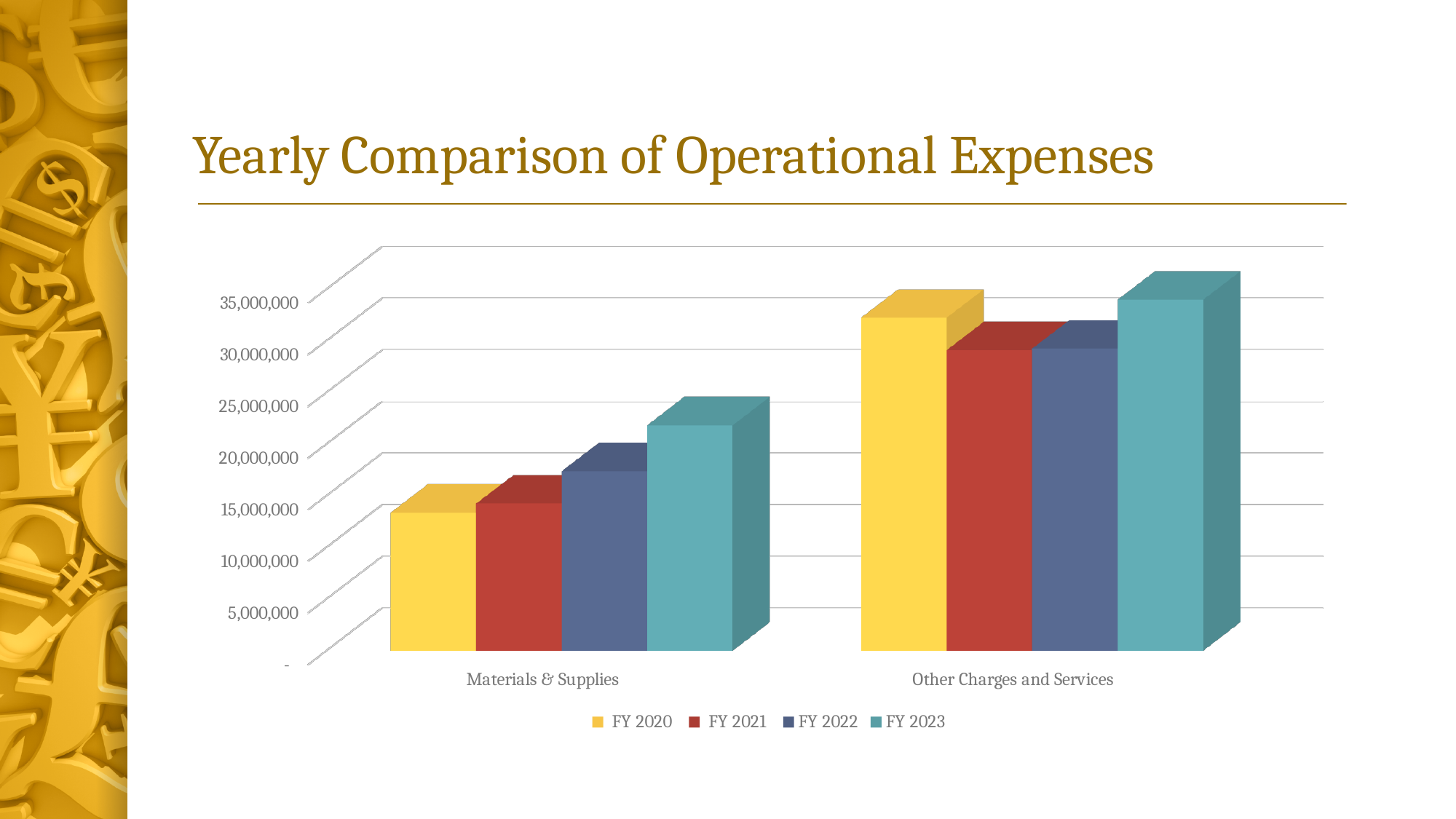
How many series does the legend list? 4 How many categories are shown on the x axis? 2 Which fiscal year has the highest value for Materials & Supplies? FY 2023 Which fiscal year has the lowest value for Materials & Supplies? FY 2020 Which fiscal year has the highest value for Other Charges and Services? FY 2023 Is the FY 2023 value for Materials & Supplies greater or less than 20,000,000? greater What is the title of the chart? Yearly Comparison of Operational Expenses Is the FY 2020 value for Other Charges and Services greater or less than 30,000,000? greater Is the FY 2021 value for Other Charges and Services greater or less than 35,000,000? less What kind of chart is shown on the slide? Bar chart Do the Materials & Supplies values rise or fall from FY 2020 to FY 2023? Rise Which is larger, the FY 2023 value for Materials & Supplies or the FY 2023 value for Other Charges and Services? Other Charges and Services